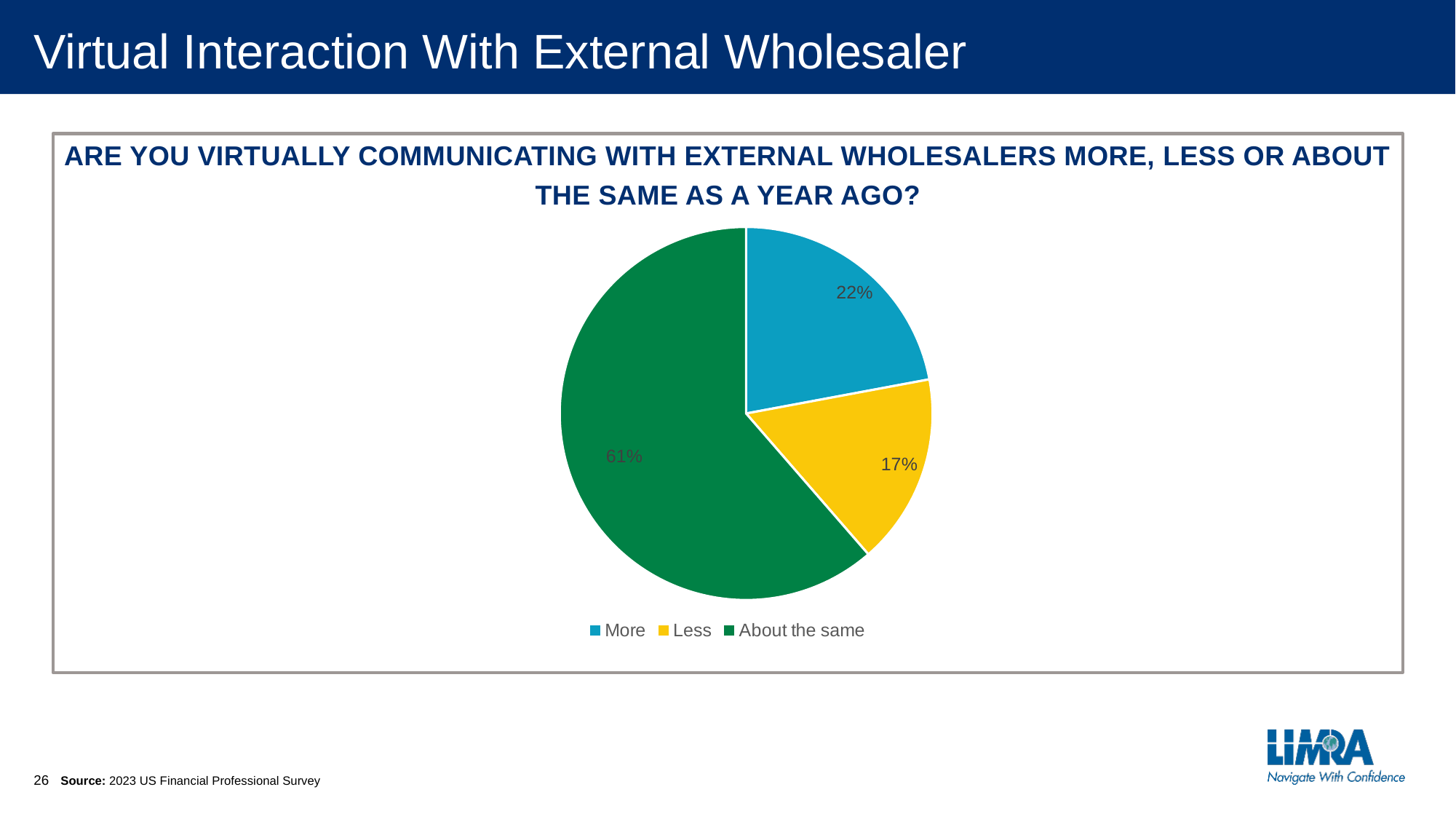
What colour is the 'About the same' slice? green What share of respondents said they are communicating virtually with external wholesalers 'More' than a year ago? 22% Which response has the smallest share of the pie? Less How many entries does the legend list? 3 Which is larger, the share for 'More' or the share for 'Less'? More Which response has the largest share of the pie? About the same What is the difference in percentage points between 'More' and 'Less'? 5 What share of respondents said 'Less'? 17% How many slices does the pie chart have? 3 What is the difference in percentage points between 'About the same' and 'More'? 39 What share of respondents said 'About the same'? 61% What kind of chart is shown on the slide? pie chart